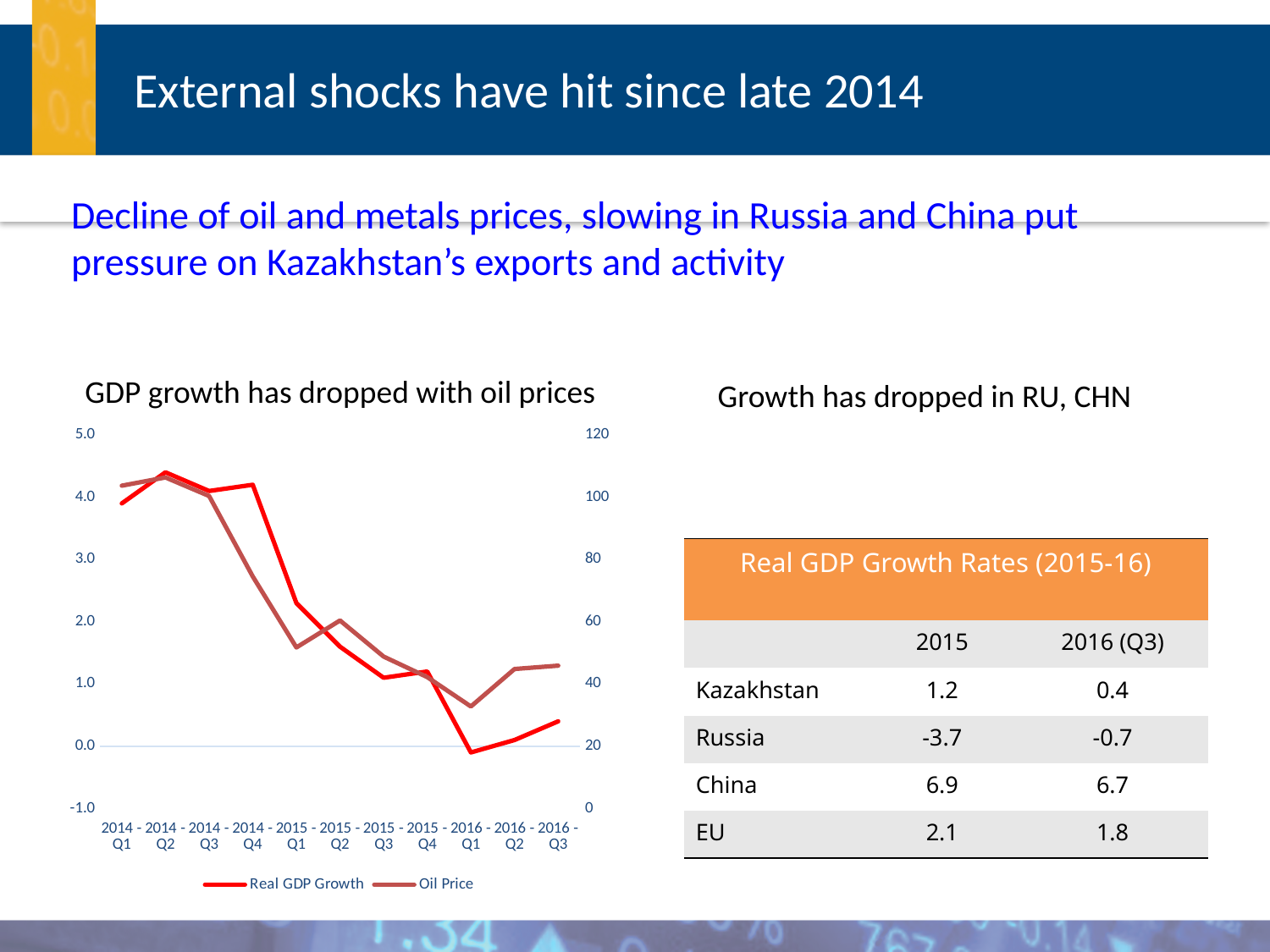
In the "GDP growth has dropped with oil prices" chart, in which quarter is Real GDP Growth lowest? 2016 - Q1 In the "GDP growth has dropped with oil prices" chart, in which quarter is the Oil Price lowest? 2016 - Q1 How many series does the legend of the "GDP growth has dropped with oil prices" chart list? 2 How many quarters are shown on the x axis of the "GDP growth has dropped with oil prices" chart? 11 In the "GDP growth has dropped with oil prices" chart, does Real GDP Growth overall rise or fall from 2014 - Q1 to 2016 - Q1? fall What kind of chart is shown under the title "GDP growth has dropped with oil prices"? line chart In the "GDP growth has dropped with oil prices" chart, is the Oil Price value for 2016 - Q1 greater or less than 40? less In the "GDP growth has dropped with oil prices" chart, is the Real GDP Growth value for 2016 - Q3 greater or less than 1.0? less In the "GDP growth has dropped with oil prices" chart, what is the highest value shown on the right-hand axis? 120 In the "GDP growth has dropped with oil prices" chart, is the Oil Price value for 2014 - Q2 greater or less than 100? greater In the "GDP growth has dropped with oil prices" chart, which is larger: the Oil Price in 2014 - Q3 or in 2015 - Q3? 2014 - Q3